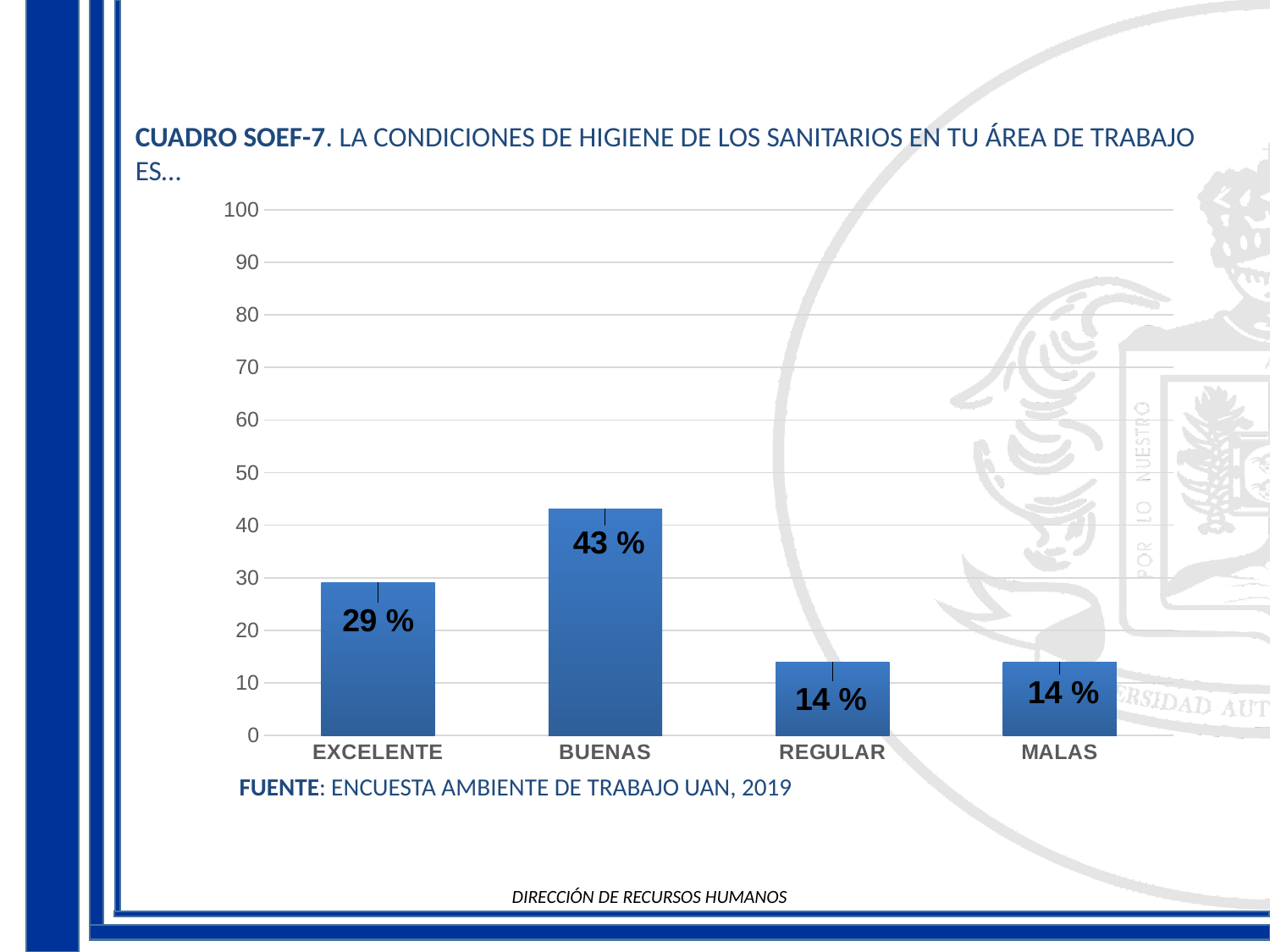
What is the difference between the values for BUENAS and EXCELENTE? 14 % Which is larger, the value for EXCELENTE or the value for MALAS? EXCELENTE What is the value for EXCELENTE? 29 % What is the value for MALAS? 14 % Which category has the highest value? BUENAS What is the value for REGULAR? 14 % What is the value for BUENAS? 43 % What kind of chart is shown on the slide? bar chart Is the value for BUENAS greater or less than 50? less What is the difference between the values for EXCELENTE and REGULAR? 15 % How many categories are shown on the x axis? 4 What is the source cited below the chart? ENCUESTA AMBIENTE DE TRABAJO UAN, 2019